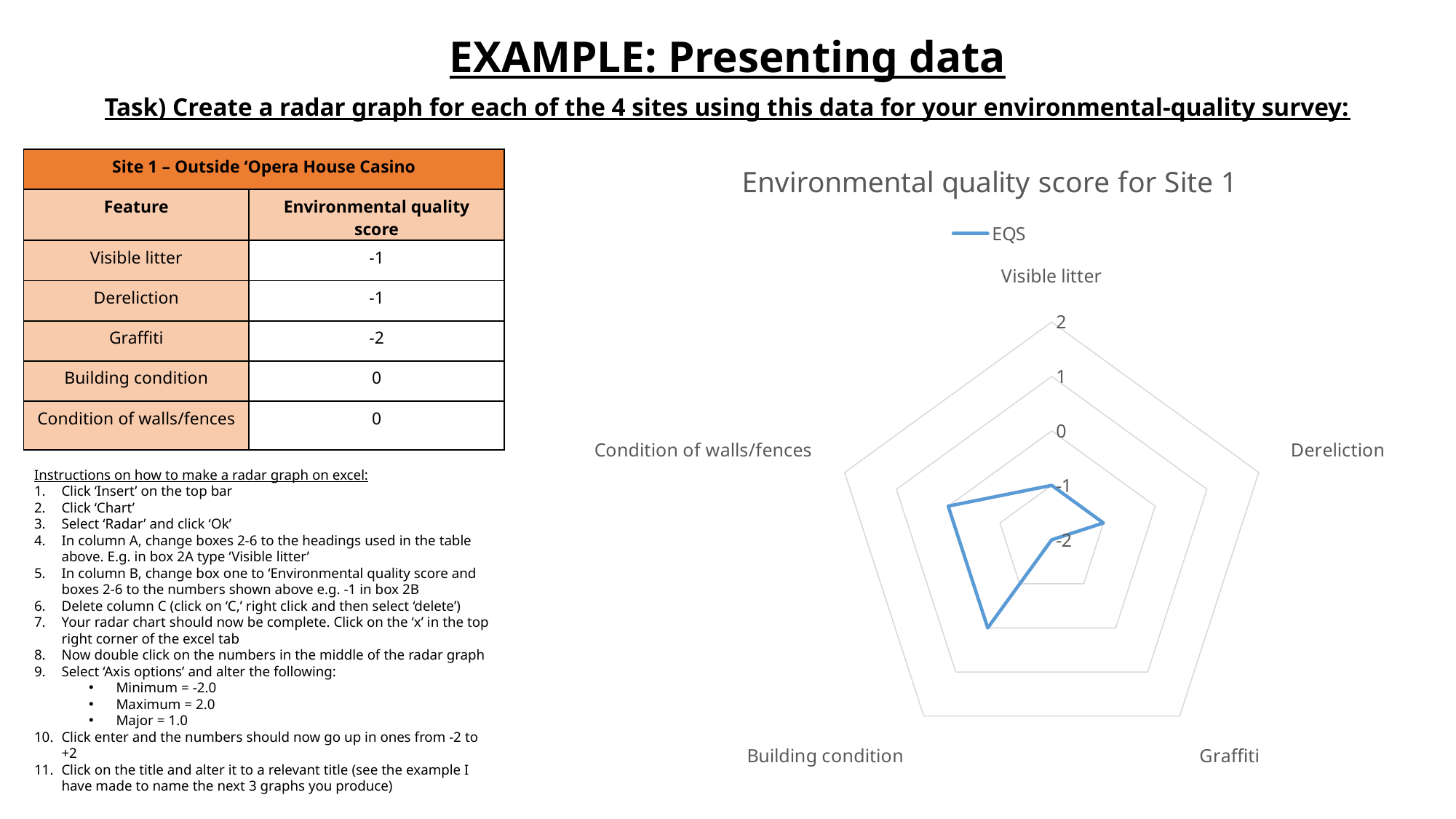
What is the name of the series shown in the chart legend? EQS What is the EQS value for Graffiti? -2 What is the difference between the EQS value for Condition of walls/fences and the EQS value for Graffiti? 2 How many categories (axes) does the radar chart have? 5 What type of chart is shown on the slide? Radar chart What is the EQS value for Visible litter? -1 How many series does the chart legend list? 1 Which category has the lowest EQS value? Graffiti What is the EQS value for Building condition? 0 Which is larger, the EQS value for Dereliction or for Graffiti? Dereliction What is the title of the chart? Environmental quality score for Site 1 Is the EQS value for Dereliction greater or less than 0? less